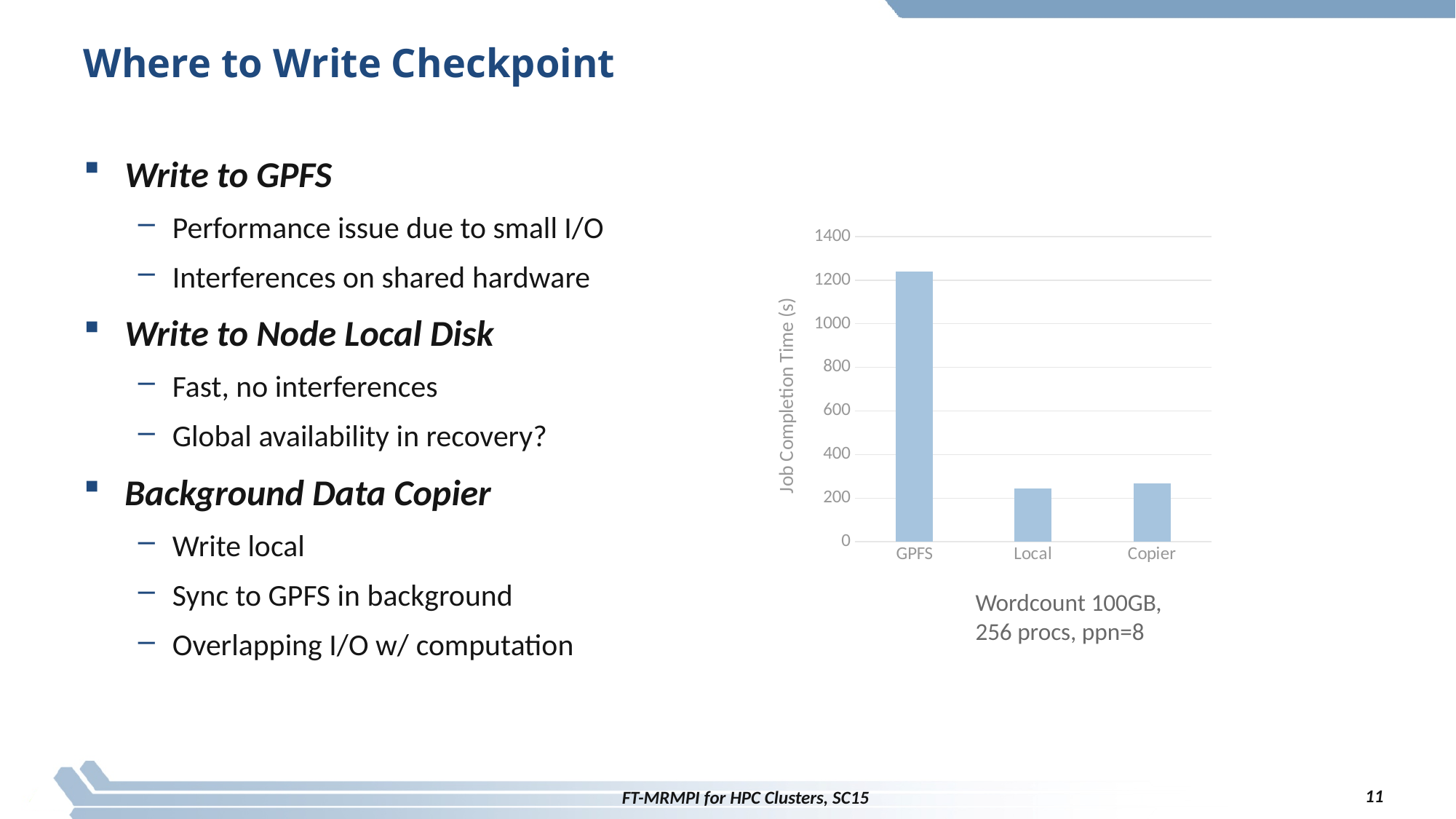
What is the label of the y axis of the chart? Job Completion Time (s) Is the job completion time for Copier greater or less than 400? less Is the job completion time for GPFS greater or less than 1000? greater What kind of chart is shown on the slide? bar chart Is the job completion time for Local greater or less than 400? less Which has a larger job completion time, GPFS or Copier? GPFS What workload is described in the caption below the chart? Wordcount 100GB, 256 procs, ppn=8 Which has a larger job completion time, GPFS or Local? GPFS Which category has the highest job completion time? GPFS How many categories are plotted on the x axis of the chart? 3 Which category has the lowest job completion time? Local